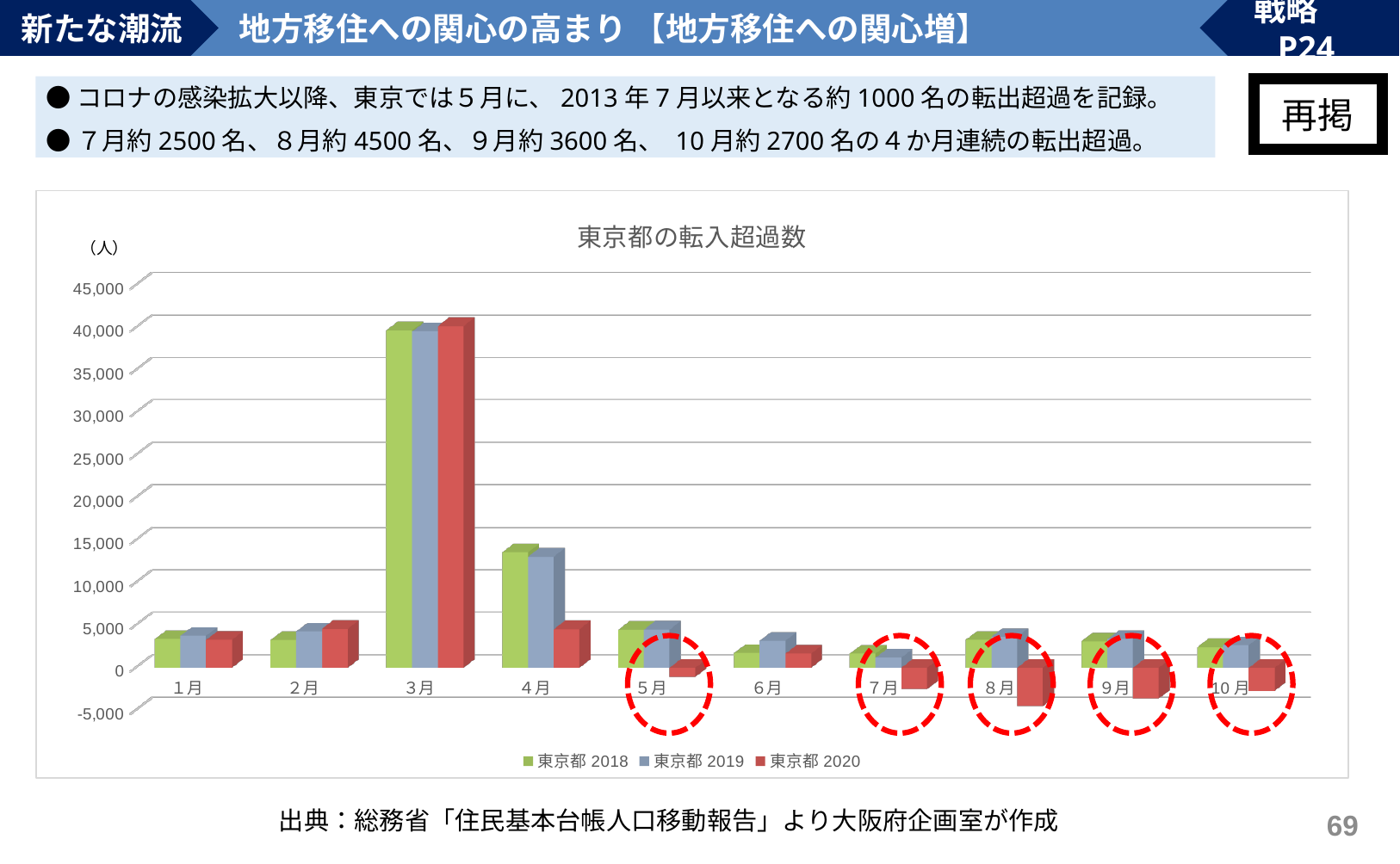
What kind of chart is shown on the slide? bar chart Which is larger for 7月: the 東京都 2019 value or the 東京都 2020 value? 東京都 2019 What is the title of the chart? 東京都の転入超過数 For the 東京都 2018 series, do the values rise or fall from 3月 to 5月? fall Is the value for 3月 in the 東京都 2020 series greater or less than 35,000? greater How many months are shown on the x axis of the chart? 10 Which is larger for 4月: the 東京都 2018 value or the 東京都 2020 value? 東京都 2018 Is the value for 4月 in the 東京都 2018 series greater or less than 10,000? greater Is the value for 5月 in the 東京都 2020 series greater or less than 0? less How many series does the legend of the chart list? 3 Which month has the highest value for the 東京都 2020 series? 3月 Which month has the lowest value for the 東京都 2020 series? 8月